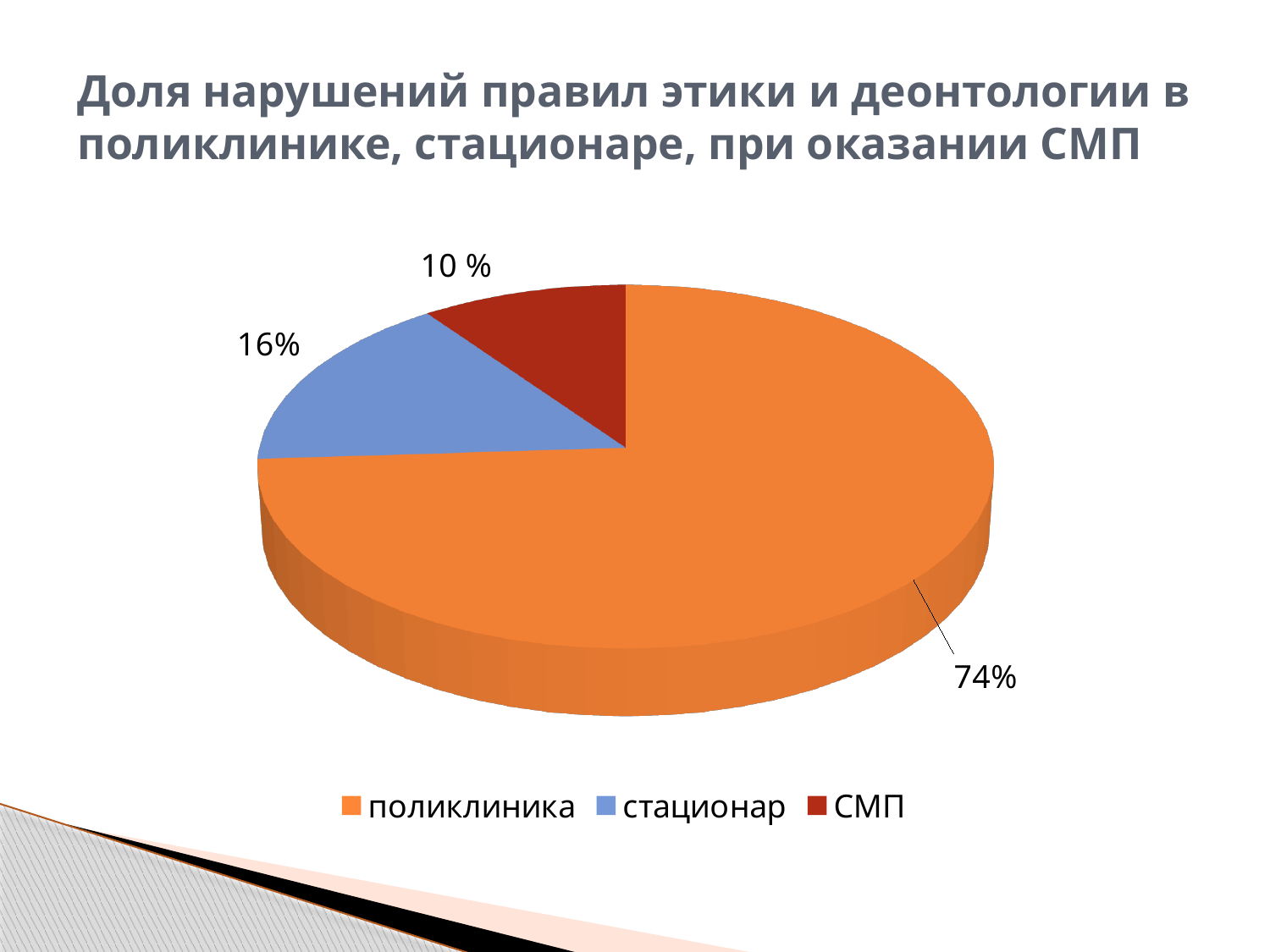
What kind of chart is shown on the slide? pie chart What colour is the slice for стационар? blue Which is larger, the share for стационар or the share for СМП? стационар What is the value shown for СМП? 10 % What is the difference between the shares for поликлиника and стационар? 58% What is the value shown for стационар? 16% What share of the pie does поликлиника account for? 74% Which category has the largest slice of the pie? поликлиника What is the title of the chart? Доля нарушений правил этики и деонтологии в поликлинике, стационаре, при оказании СМП How many categories are shown in the pie chart? 3 What is the difference between the shares for стационар and СМП? 6% Which category has the smallest slice of the pie? СМП